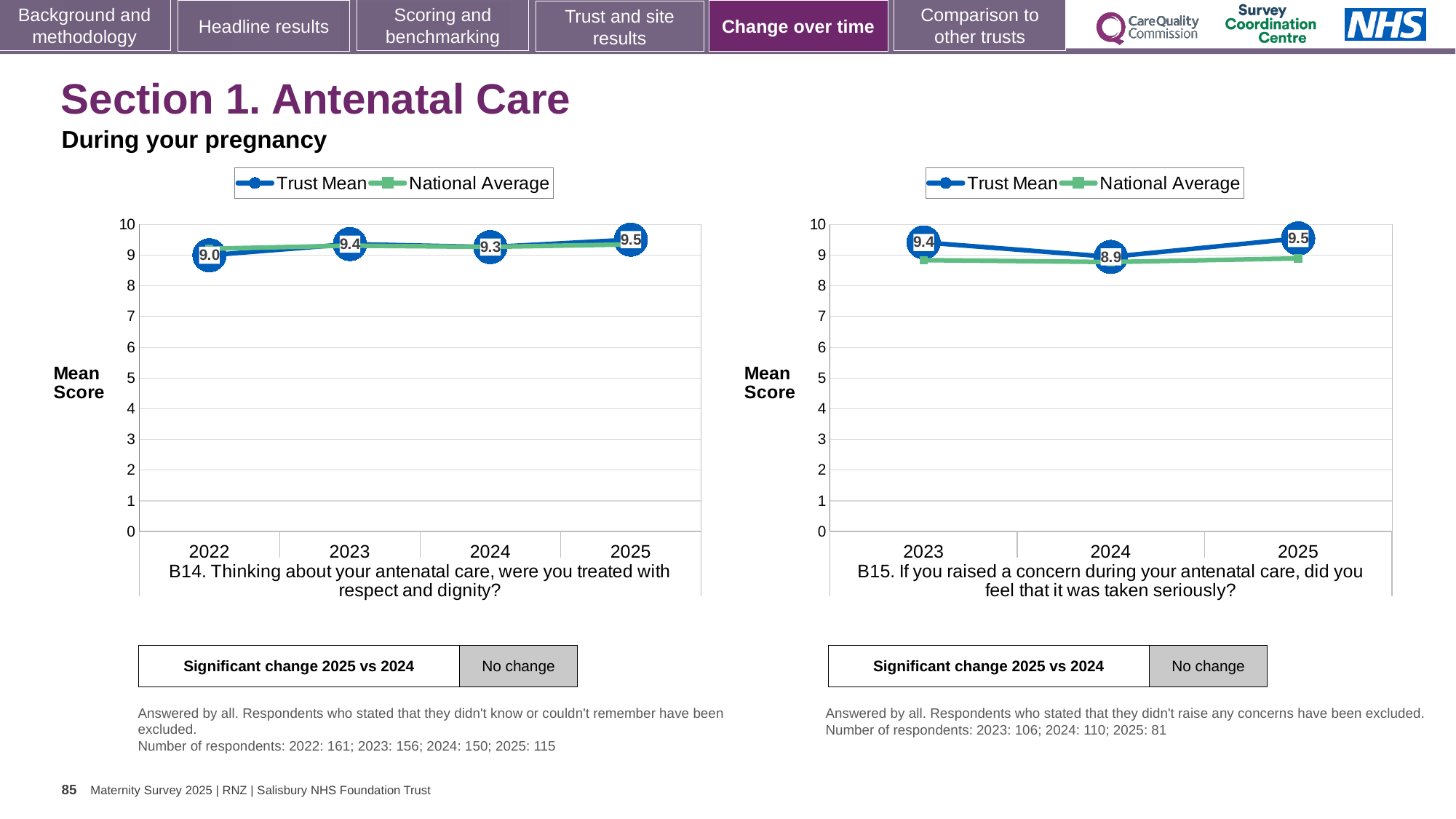
In the B14 chart (left), which year has the lowest Trust Mean? 2022 In the B15 chart (right), what is the difference between the Trust Mean for 2025 and 2024? 0.6 In the B15 chart (right), what is the Trust Mean for 2024? 8.9 In the B14 chart (left), what is the Trust Mean for 2025? 9.5 In the B15 chart (right), which year has the highest Trust Mean? 2025 What kind of chart is the B14 chart (left)? Line chart In the B14 chart (left), is the Trust Mean higher in 2023 or 2024? 2023 In the B14 chart (left), what is the Trust Mean for 2022? 9.0 How many series does the legend of the B15 chart (right) list? 2 How many years are shown on the x axis of the B14 chart (left)? 4 In the B14 chart (left), does the Trust Mean rise or fall from 2022 to 2023? Rise In the B15 chart (right), is the National Average for 2025 greater or less than 8? greater